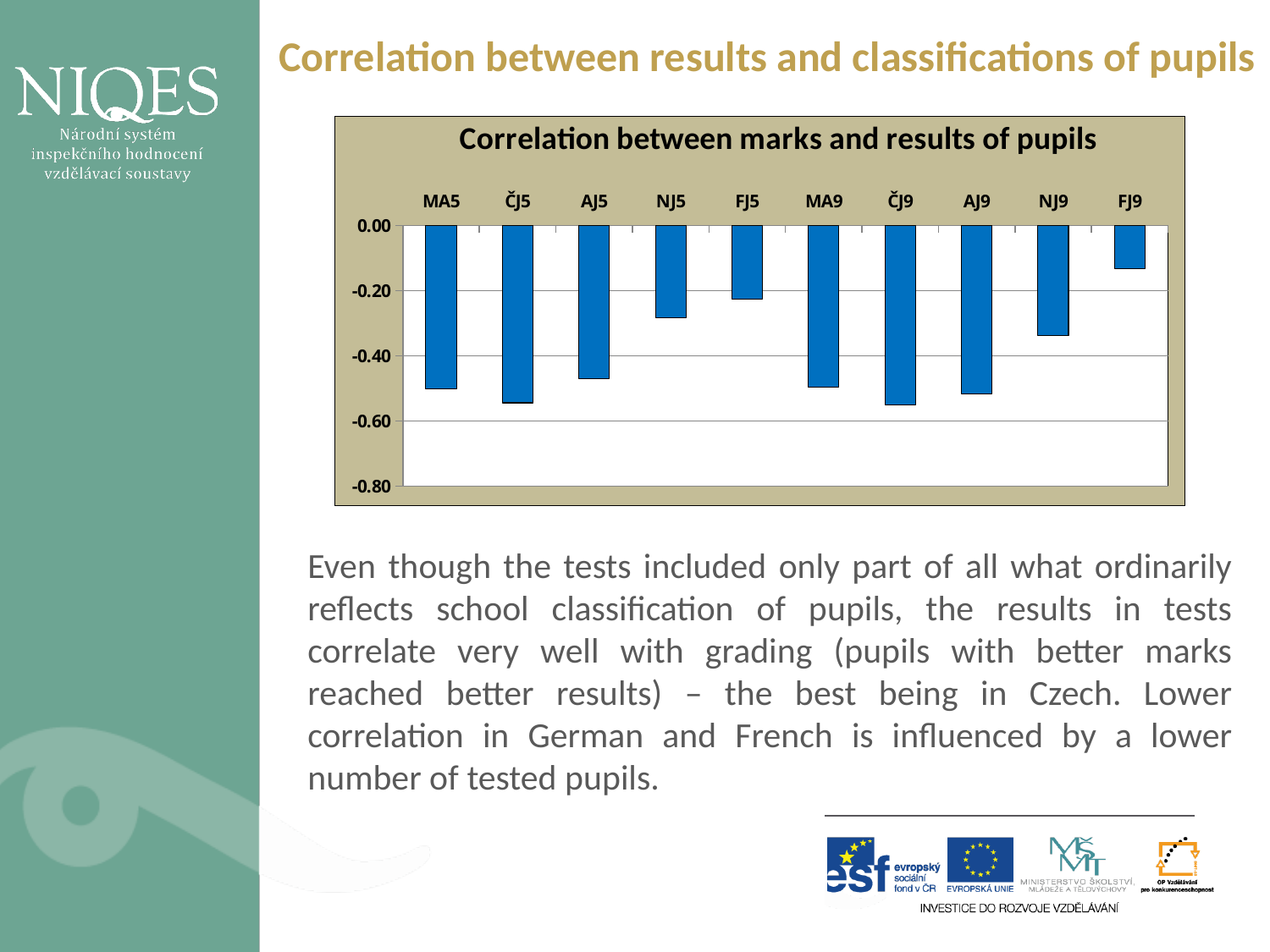
Is the value for FJ9 greater or less than -0.20? greater Is the value for NJ5 greater or less than -0.20? less Is the value for MA5 greater or less than -0.40? less How many categories are plotted in the chart? 10 What is the title of the chart? Correlation between marks and results of pupils Which category has the highest value (the bar closest to zero)? FJ9 What colour are the bars in the chart? blue What kind of chart is shown on the slide? bar chart Which bar extends further below zero, NJ9 or FJ9? NJ9 Which bar extends further below zero, MA5 or NJ5? MA5